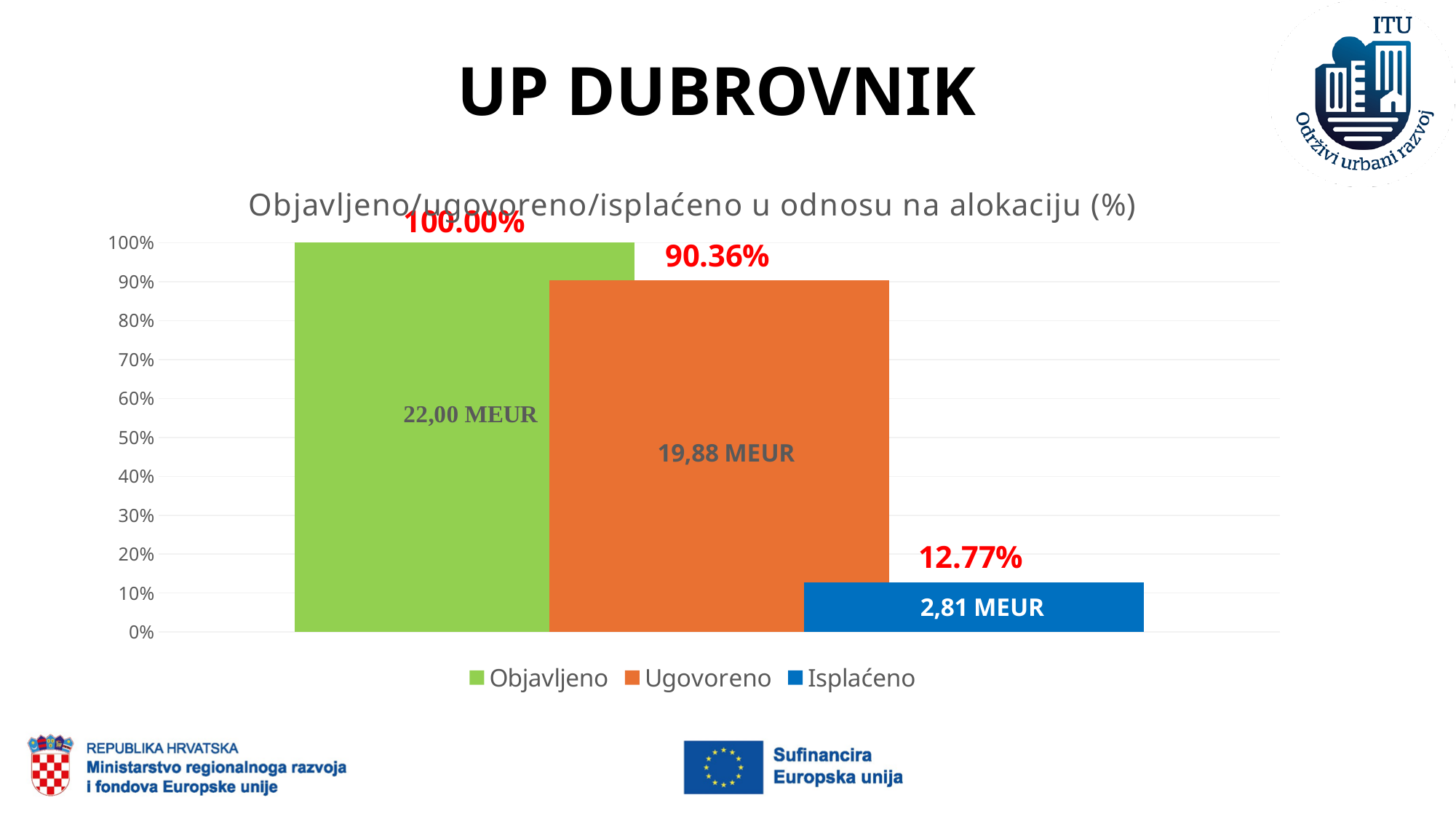
What percentage value is shown for Ugovoreno? 90.36% Which is larger, the percentage for Ugovoreno or the percentage for Isplaćeno? Ugovoreno What kind of chart is shown on the slide? bar chart What is the difference in percentage points between Objavljeno and Ugovoreno? 9.64 How many series does the legend list? 3 Which series has the highest percentage value? Objavljeno What percentage value is shown for Isplaćeno? 12.77% What is the title of the chart? Objavljeno/ugovoreno/isplaćeno u odnosu na alokaciju (%) Which series has the lowest percentage value? Isplaćeno Is the value for Isplaćeno greater or less than 20%? less What amount in MEUR is labelled on the Objavljeno bar? 22,00 MEUR What amount in MEUR is labelled on the Isplaćeno bar? 2,81 MEUR